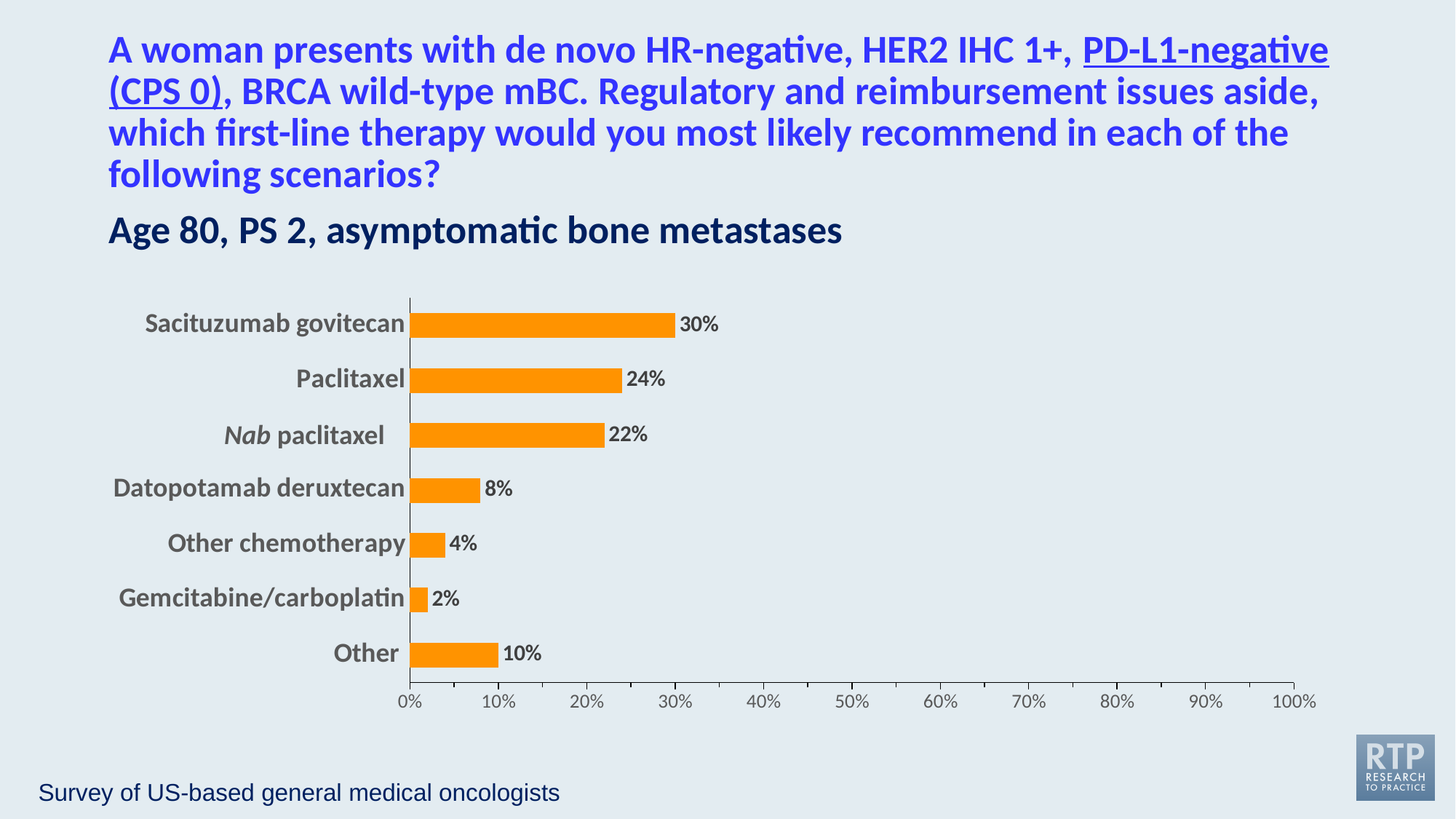
What is the value shown for paclitaxel? 24% What is the difference between the values for nab paclitaxel and datopotamab deruxtecan? 14% Which therapy has the highest percentage? Sacituzumab govitecan What is the difference between the percentages for sacituzumab govitecan and paclitaxel? 6% Which therapy has the lowest percentage? Gemcitabine/carboplatin How many therapy categories are shown in the chart? 7 What percentage of respondents chose sacituzumab govitecan? 30% Is the value for nab paclitaxel greater or less than 20%? greater What is the value for gemcitabine/carboplatin? 2% What type of chart is shown on the slide? Bar chart Which has a larger value, Other or other chemotherapy? Other What percentage is shown for datopotamab deruxtecan? 8%